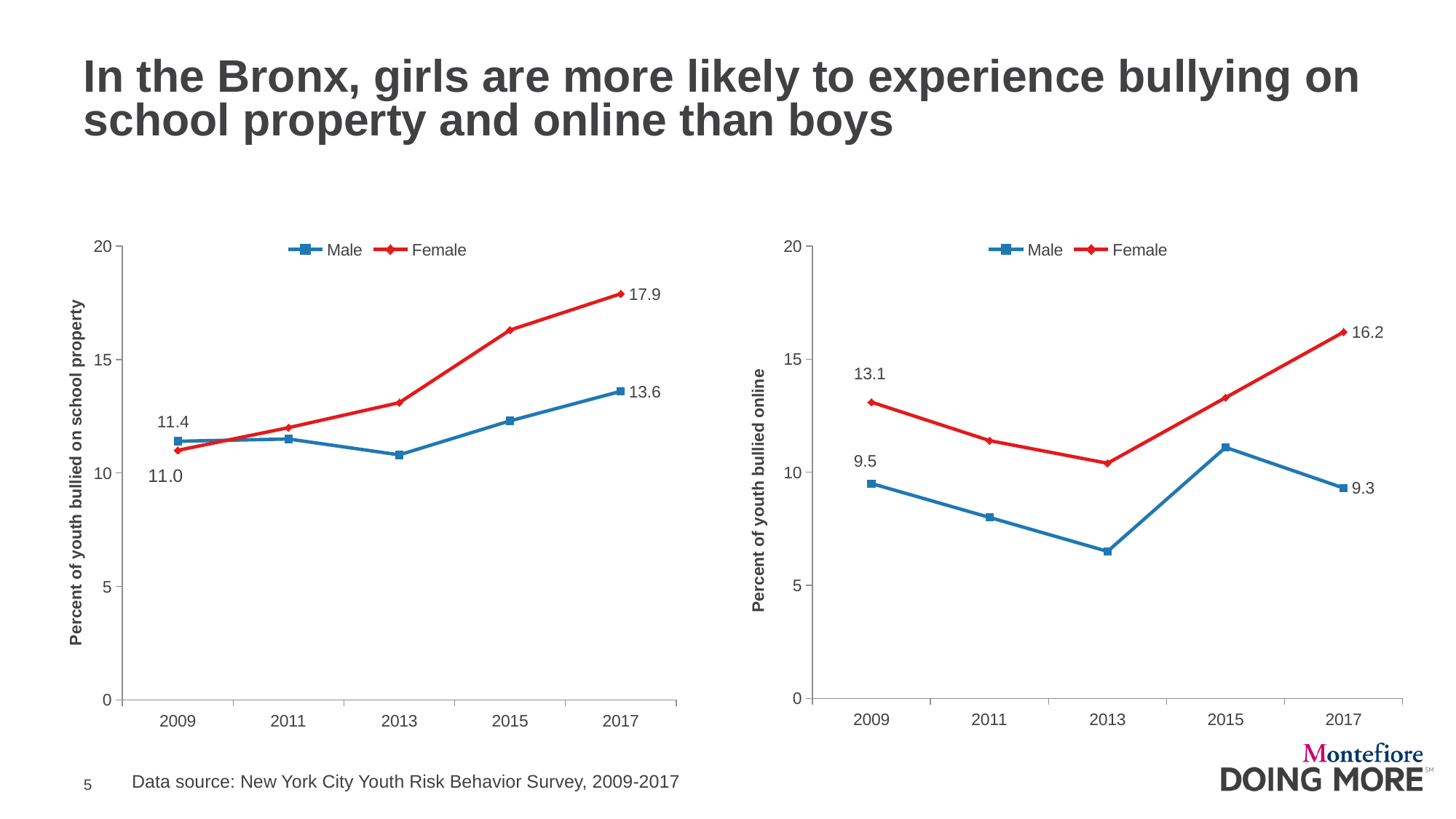
On the left chart (bullied on school property), what is the Female value in 2017? 17.9 How many years are plotted on the x axis of the right chart (bullied online)? 5 On the right chart (bullied online), is the Male value in 2013 greater or less than 10? less What kind of chart is the right chart (bullied online)? Line chart On the left chart (bullied on school property), which series has the higher value in 2009, Male or Female? Male How many series does the legend of the left chart (bullied on school property) list? 2 On the right chart (bullied online), what is the difference between the Female and Male values in 2017? 6.9 On the right chart (bullied online), what is the Female value in 2009? 13.1 On the left chart (bullied on school property), what is the Male value in 2009? 11.4 On the left chart (bullied on school property), is the Female value in 2015 greater or less than 15? greater On the right chart (bullied online), what is the Male value in 2017? 9.3 On the left chart (bullied on school property), what is the difference between the Female and Male values in 2017? 4.3